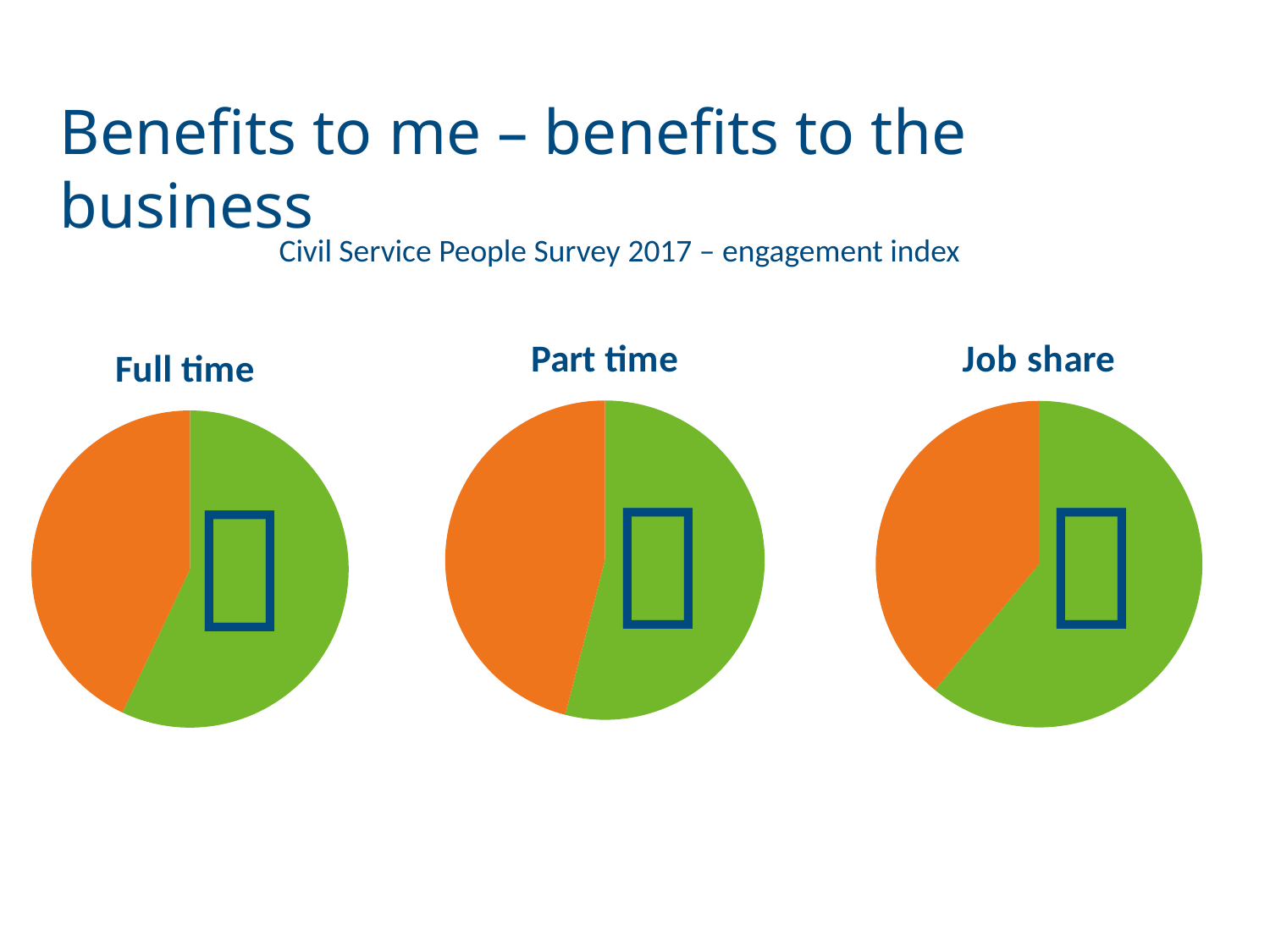
How many pie charts are shown on the slide? 3 Which of the three pie charts has the largest green slice? Job share Is the green slice in the Job share pie chart larger or smaller than the green slice in the Part time pie chart? larger In the Full time pie chart, which slice is larger, the green one or the orange one? green What subtitle appears above the three pie charts? Civil Service People Survey 2017 – engagement index How many slices does the Job share pie chart have? 2 What is the title of the pie chart on the left? Full time In the Job share pie chart, which slice is larger, the green one or the orange one? green Which of the three pie charts has the smallest orange slice? Job share What kind of chart is used for the Full time data? pie chart